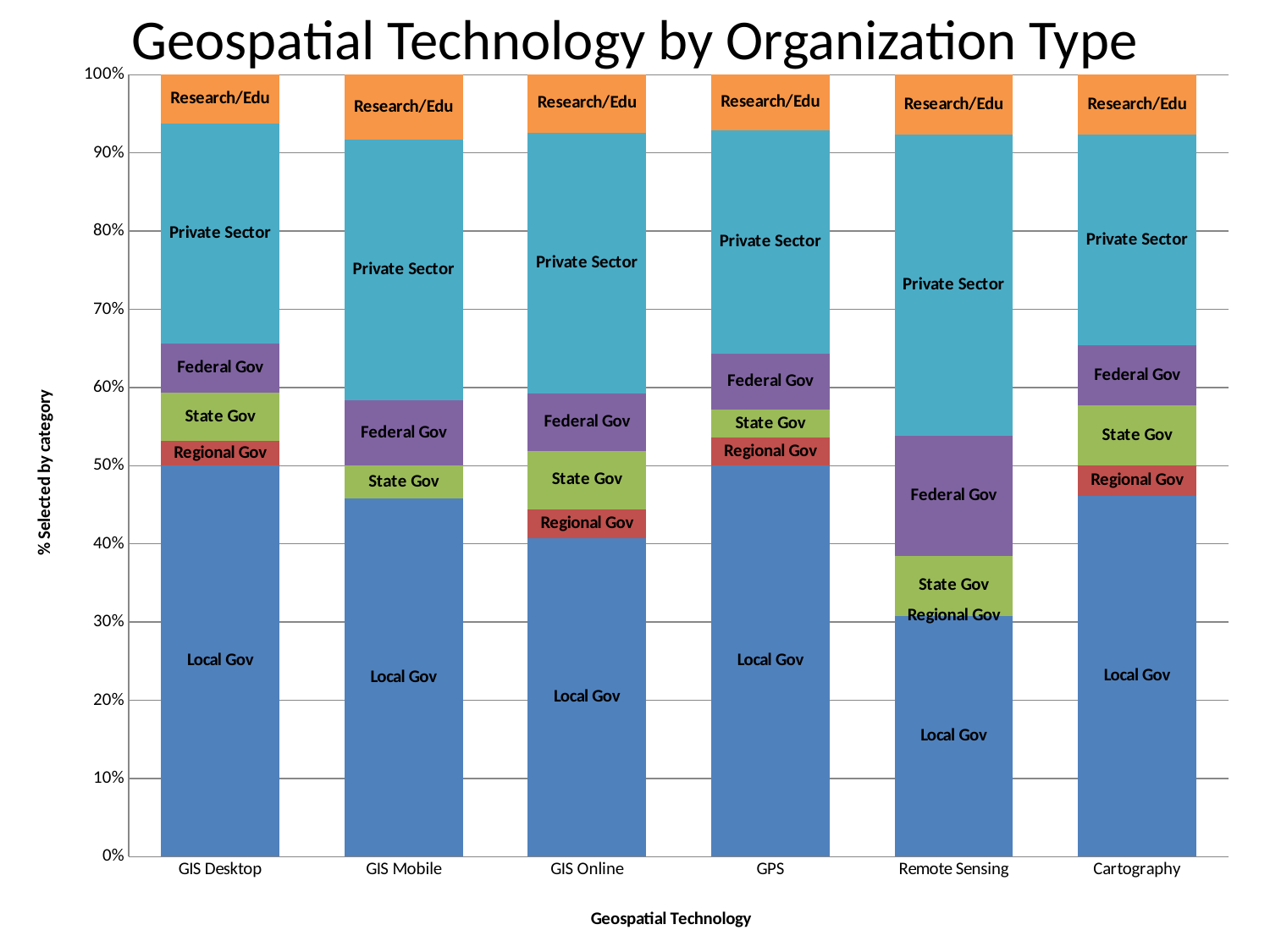
What kind of chart is shown on the slide? Stacked bar chart How many organization types are stacked in each bar? 6 Which has the larger Local Gov share, GIS Desktop or Remote Sensing? GIS Desktop Which geospatial technology has the smallest Local Gov share? Remote Sensing What is the label on the y axis? % Selected by category Which has the larger Federal Gov share, Remote Sensing or GIS Desktop? Remote Sensing How many geospatial technologies are shown along the x axis? 6 What is the title of the chart? Geospatial Technology by Organization Type Is the Local Gov share for Remote Sensing greater or less than 40%? less Is the Local Gov share for GIS Online greater or less than 50%? less Which geospatial technology has the largest Private Sector share? Remote Sensing Which geospatial technology has the largest Federal Gov share? Remote Sensing